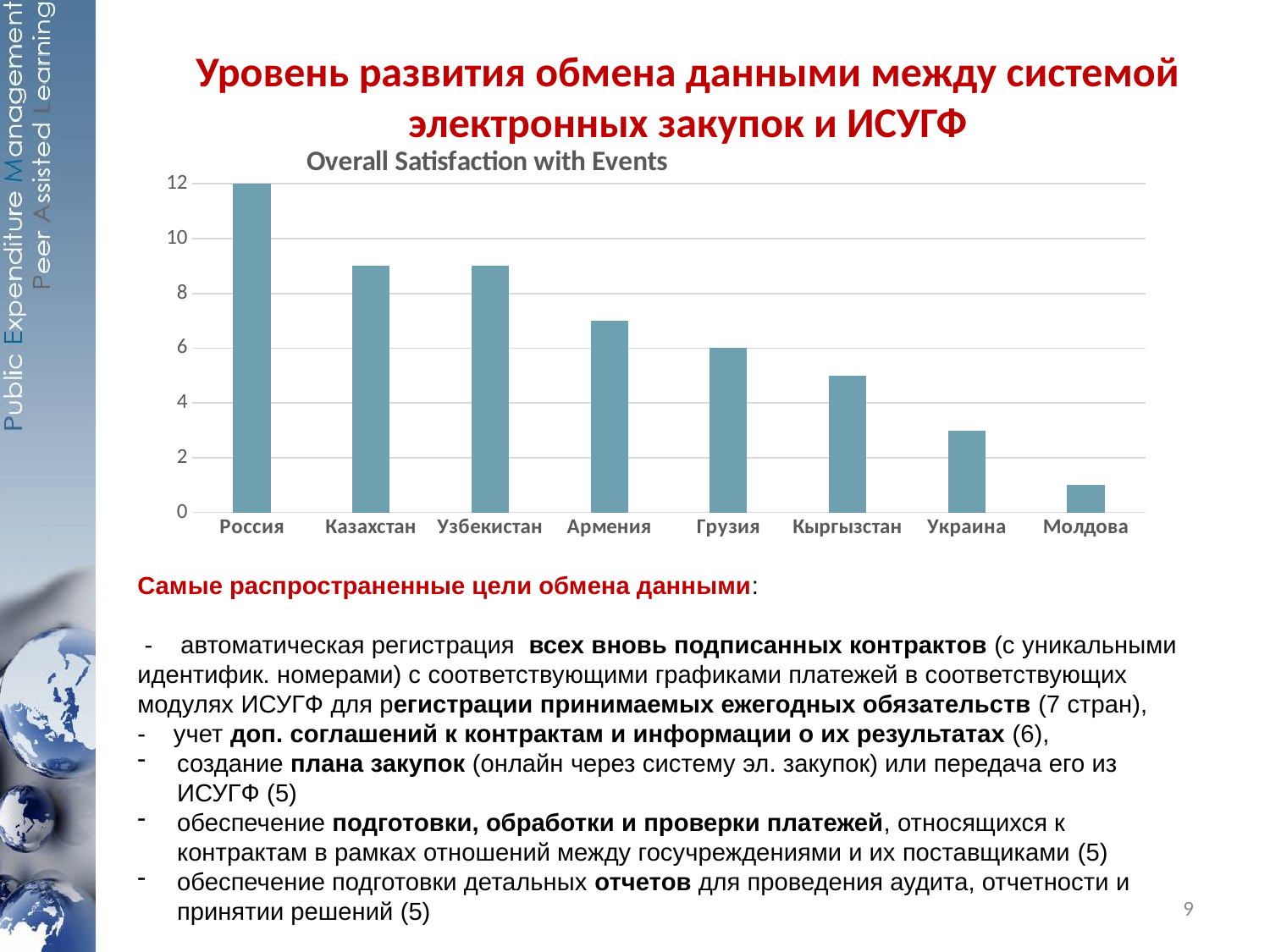
What is the title printed above the chart? Overall Satisfaction with Events Is the value for Украина greater or less than 4? less How many countries are shown on the x axis of the chart? 8 What is the difference between the values for Россия and Грузия? 6 What is the value for Россия in the chart? 12 Is the value for Казахстан greater or less than 8? greater Which country has the lowest bar in the chart? Молдова Which country has the highest bar in the chart? Россия What is the value for Грузия in the chart? 6 What kind of chart is shown on the slide? bar chart Which has the larger value, Армения or Кыргызстан? Армения Do the bar values rise or fall from left to right along the x axis? fall